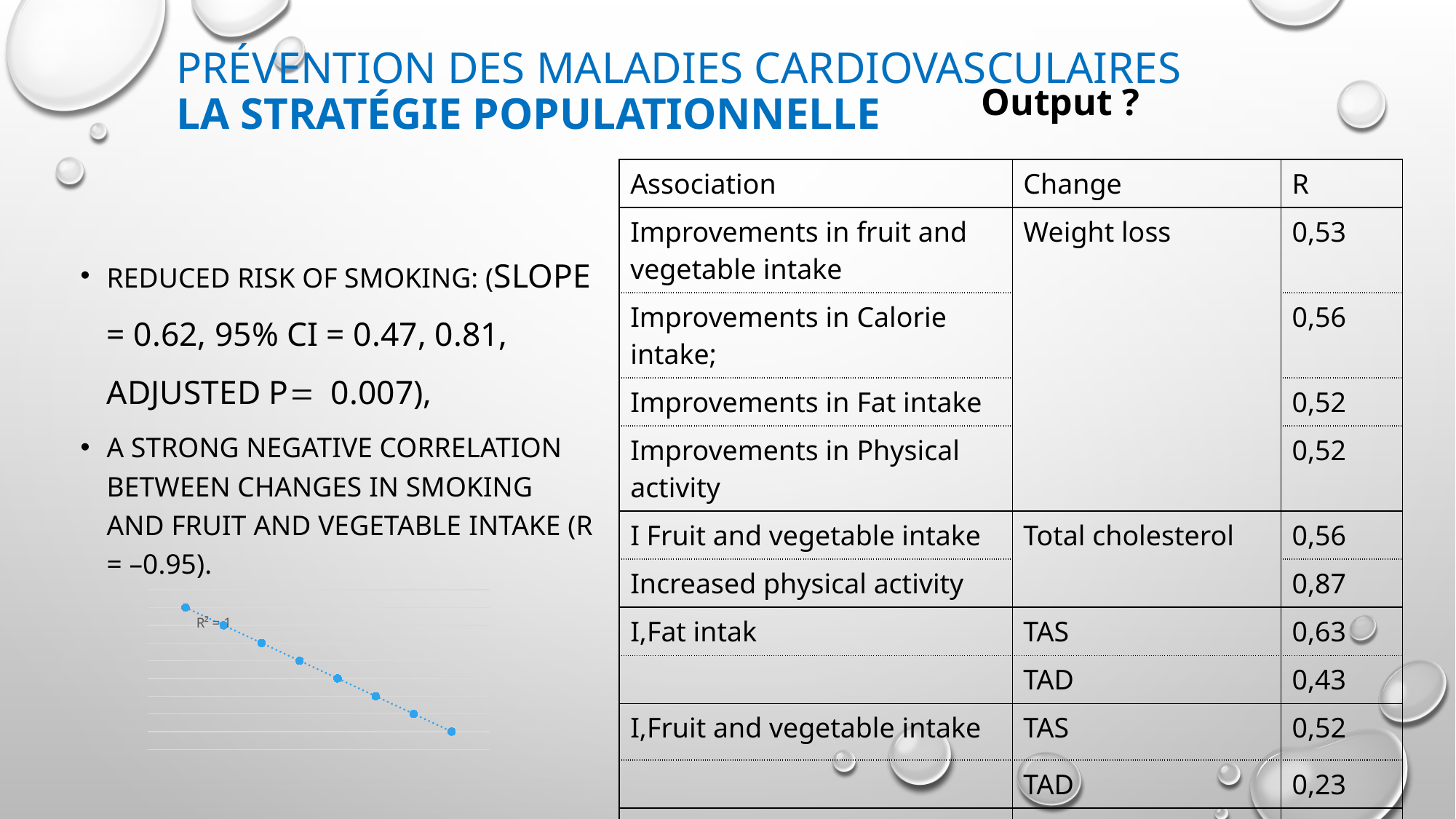
What R² value is printed on the chart at the bottom left of the slide? R² = 1 What kind of chart is shown at the bottom left of the slide? Scatter chart What colour are the plotted points in the chart at the bottom left of the slide? Blue In the chart at the bottom left of the slide, do the plotted points rise or fall from left to right? Fall How many data points are plotted in the chart at the bottom left of the slide? 8